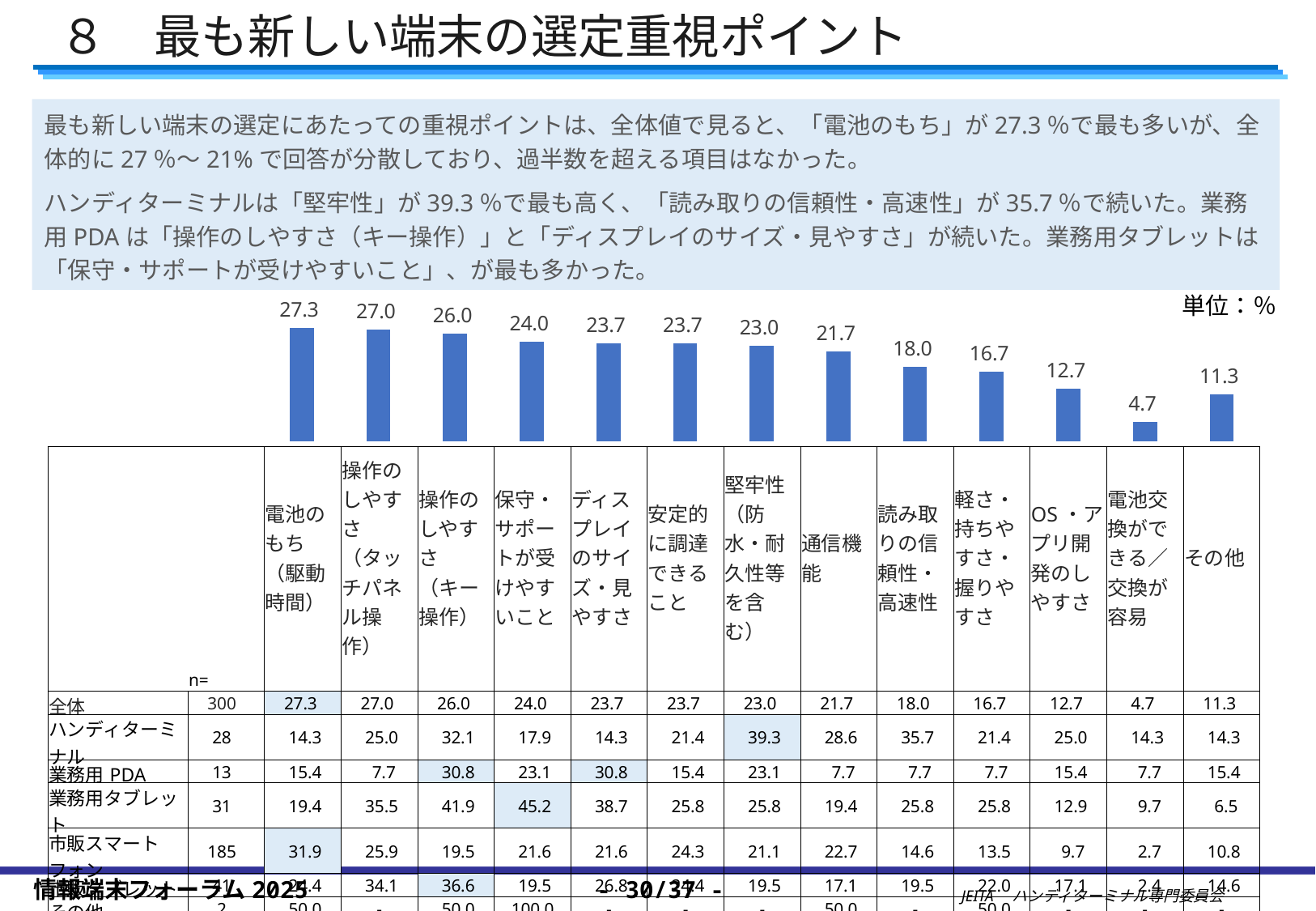
What is the difference between the values for 電池のもち（駆動時間） and 通信機能? 5.6 What unit is indicated for the values in the chart? % Which category has the highest bar in the chart? 電池のもち（駆動時間） What is the value for 堅牢性（防水・耐久性等を含む） in the bar chart? 23.0 What is the value for その他 in the bar chart? 11.3 Which category has the lowest bar in the chart? 電池交換ができる／交換が容易 What is the value for 電池のもち（駆動時間） in the bar chart? 27.3 What kind of chart is shown on the slide? bar chart How many bars are shown in the chart? 13 What is the value for 電池交換ができる／交換が容易 in the bar chart? 4.7 Which is larger, the value for 読み取りの信頼性・高速性 or the value for 軽さ・持ちやすさ・握りやすさ? 読み取りの信頼性・高速性 Do the bar values generally rise or fall from left to right across the chart? fall